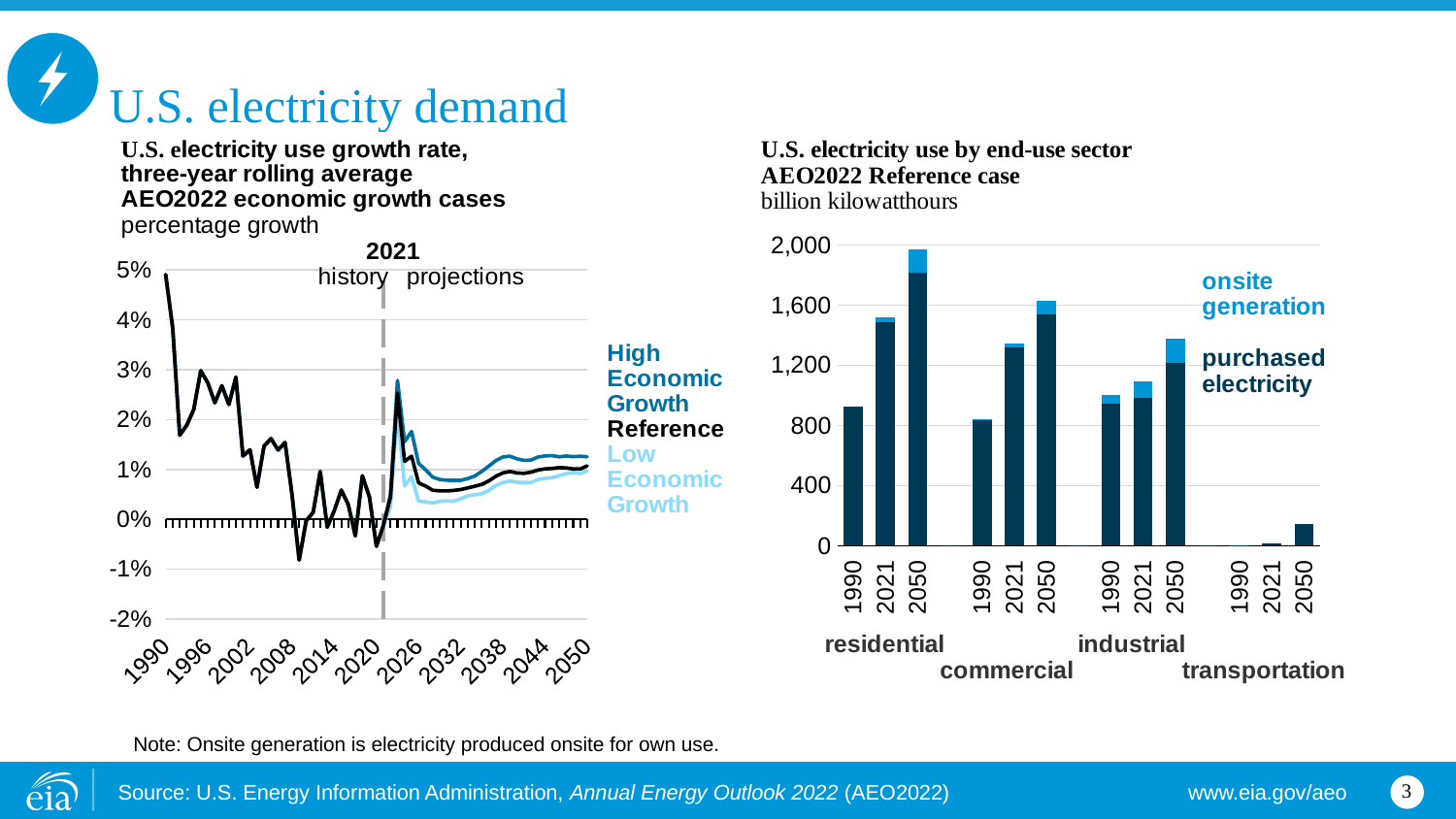
In the 'U.S. electricity use growth rate' chart, how many economic growth cases (series) are plotted? 3 What type of chart is the 'U.S. electricity use growth rate' chart on the left? line chart In the 'U.S. electricity use by end-use sector' chart, which is larger in 2050: residential or industrial? residential In the 'U.S. electricity use by end-use sector' chart, which sector has the smallest bars overall? transportation In the 'U.S. electricity use by end-use sector' chart, how many series does the legend list? 2 In the 'U.S. electricity use by end-use sector' chart, is the total for transportation in 2050 greater or less than 400 billion kilowatthours? less In the 'U.S. electricity use growth rate' chart, is the growth rate in 1990 greater or less than 4%? greater What type of chart is the 'U.S. electricity use by end-use sector' chart on the right? stacked bar chart In the 'U.S. electricity use by end-use sector' chart, is the total for residential in 1990 greater or less than 800 billion kilowatthours? greater In the 'U.S. electricity use by end-use sector' chart, which sector and year has the tallest bar? residential, 2050 In the 'U.S. electricity use growth rate' chart, what year does the dashed vertical line separating history from projections mark? 2021